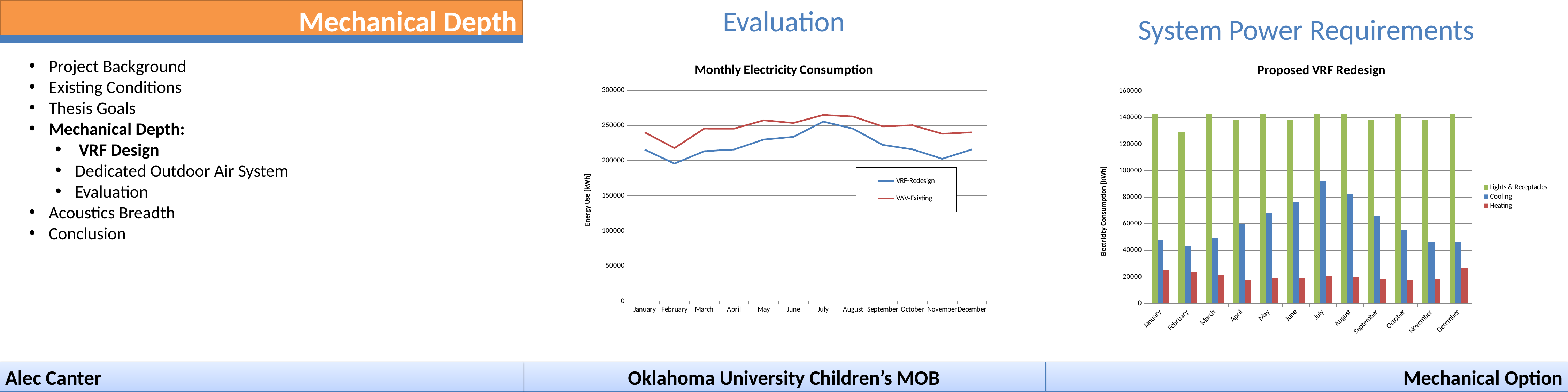
How many series does the legend of the "Monthly Electricity Consumption" chart list? 2 In the "Monthly Electricity Consumption" chart, which series is higher in July, VRF-Redesign or VAV-Existing? VAV-Existing In the "Monthly Electricity Consumption" chart, which month has the highest VRF-Redesign value? July How many series does the legend of the "Proposed VRF Redesign" chart list? 3 In the "Monthly Electricity Consumption" chart, is the VRF-Redesign value for February greater or less than 200000? less What kind of chart is the "Monthly Electricity Consumption" chart? line chart How many months are shown on the x axis of the "Proposed VRF Redesign" chart? 12 In the "Proposed VRF Redesign" chart, which month has the lowest Lights & Receptacles value? February In the "Monthly Electricity Consumption" chart, which month has the lowest VAV-Existing value? February In the "Proposed VRF Redesign" chart, is the Cooling value for July greater or less than 80000? greater In the "Proposed VRF Redesign" chart, which month has the highest Cooling value? July What kind of chart is the "Proposed VRF Redesign" chart? bar chart